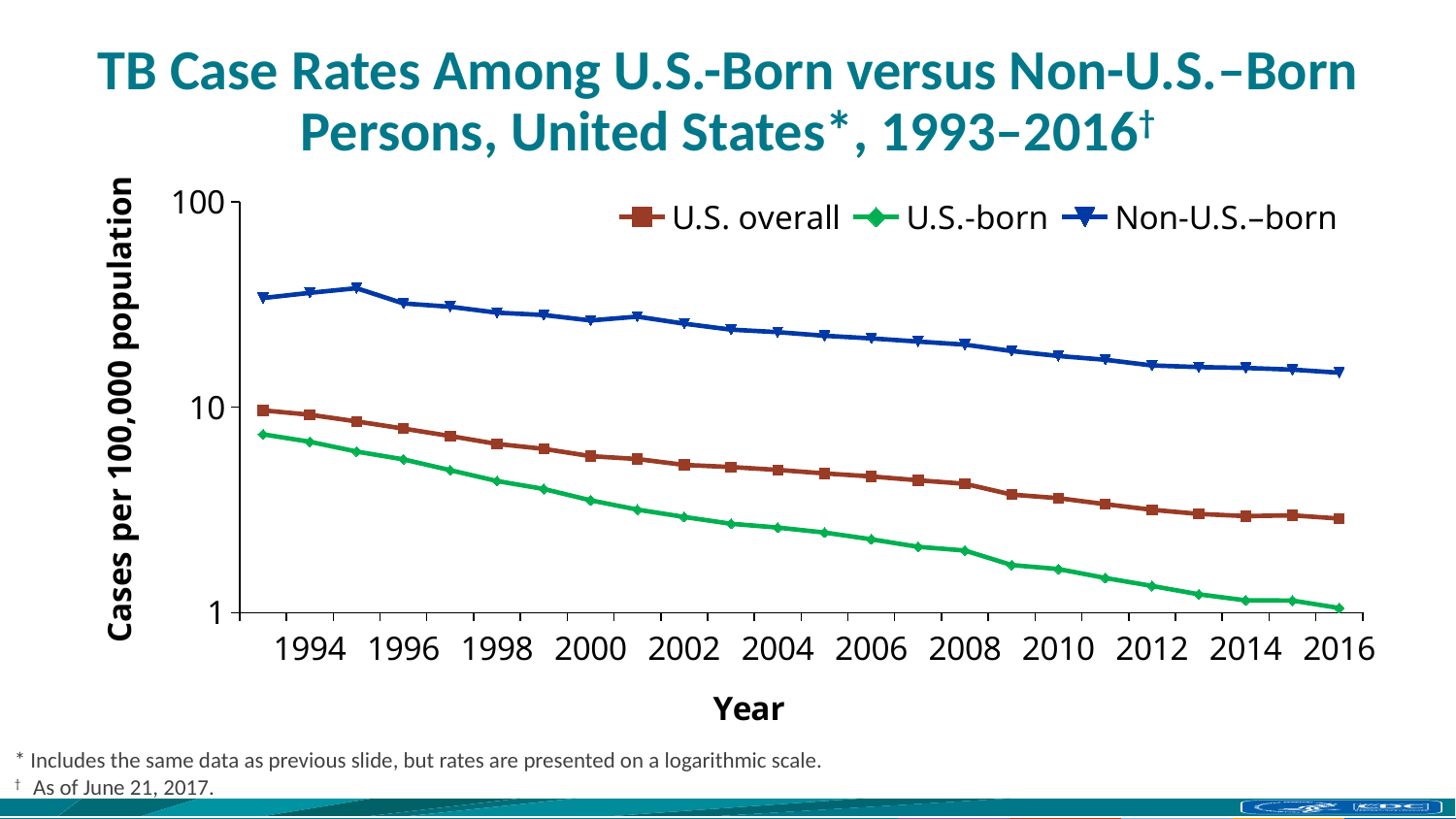
Does the U.S.-born case rate rise or fall from 1993 to 2016? fall Which series has the highest case rate in 2016? Non-U.S.–born Which is larger in 2010, the U.S. overall rate or the U.S.-born rate? U.S. overall What colour is the line for Non-U.S.–born persons? blue Which series has the lowest case rate in 2016? U.S.-born Is the value for U.S. overall in 2016 greater or less than 10? less What kind of chart is shown on the slide? line chart Is the value for Non-U.S.–born persons in 1994 greater or less than 10? greater Is the value for U.S.-born persons in 2016 greater or less than 10? less What is the label of the y axis? Cases per 100,000 population How many series does the legend list? 3